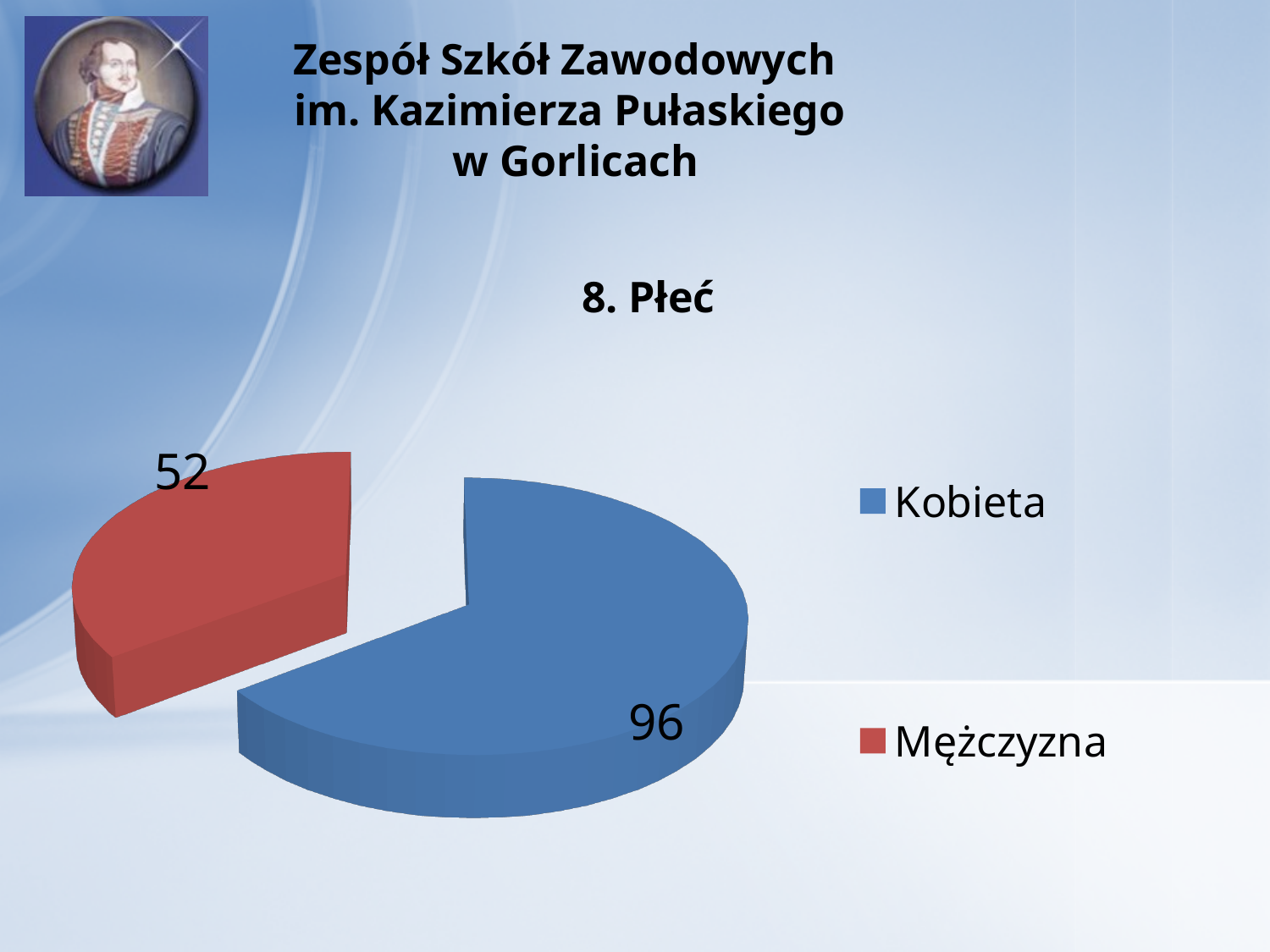
How many categories does the pie chart show? 2 What colour is the Mężczyzna slice? red What is the value for Mężczyzna? 52 What kind of chart is shown on the slide? pie chart Which is larger, the value for Kobieta or the value for Mężczyzna? Kobieta Which category has the smallest slice? Mężczyzna What is the value for Kobieta? 96 What share of the pie does Kobieta represent, to the nearest percent? 65% What is the title of the chart? 8. Płeć What is the total of all slices in the pie chart? 148 Which category has the largest slice? Kobieta What is the difference between the values for Kobieta and Mężczyzna? 44